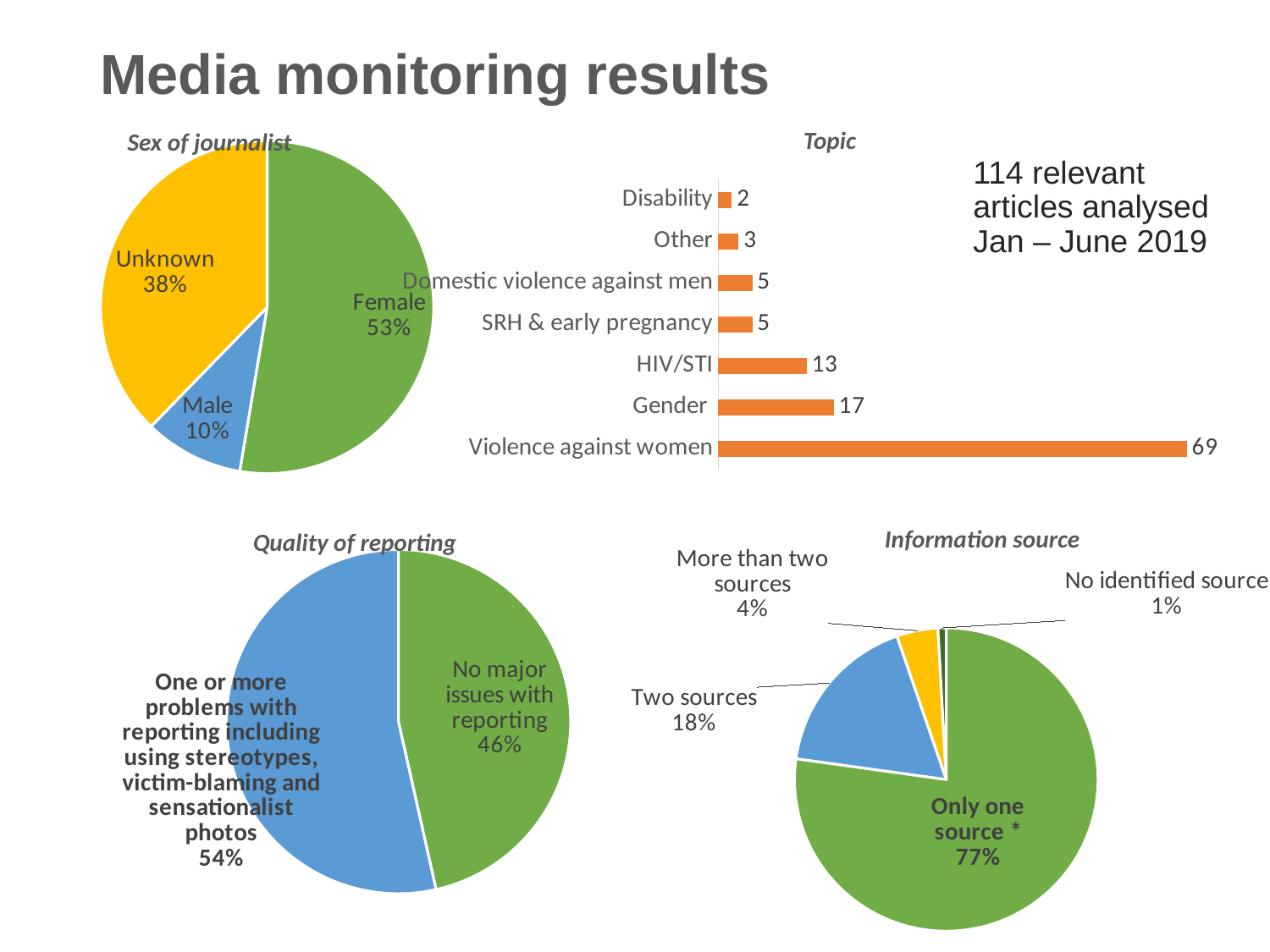
In the 'Topic' bar chart, how many articles covered violence against women? 69 In the 'Sex of journalist' pie chart, which category has the smallest share? Male In the 'Topic' bar chart, which has more articles: SRH & early pregnancy or Other? SRH & early pregnancy In the 'Topic' bar chart, which topic has the lowest count? Disability How many charts are shown on the slide? 4 In the 'Information source' pie chart, what share of articles used two sources? 18% What kind of chart is the 'Topic' chart? Bar chart In the 'Sex of journalist' pie chart, what share of articles were written by female journalists? 53% In the 'Information source' pie chart, which category has the largest share? Only one source * In the 'Quality of reporting' pie chart, what share of articles had no major issues with reporting? 46% In the 'Topic' bar chart, how many topic categories are shown? 7 In the 'Topic' bar chart, what is the difference between the Gender and HIV/STI counts? 4